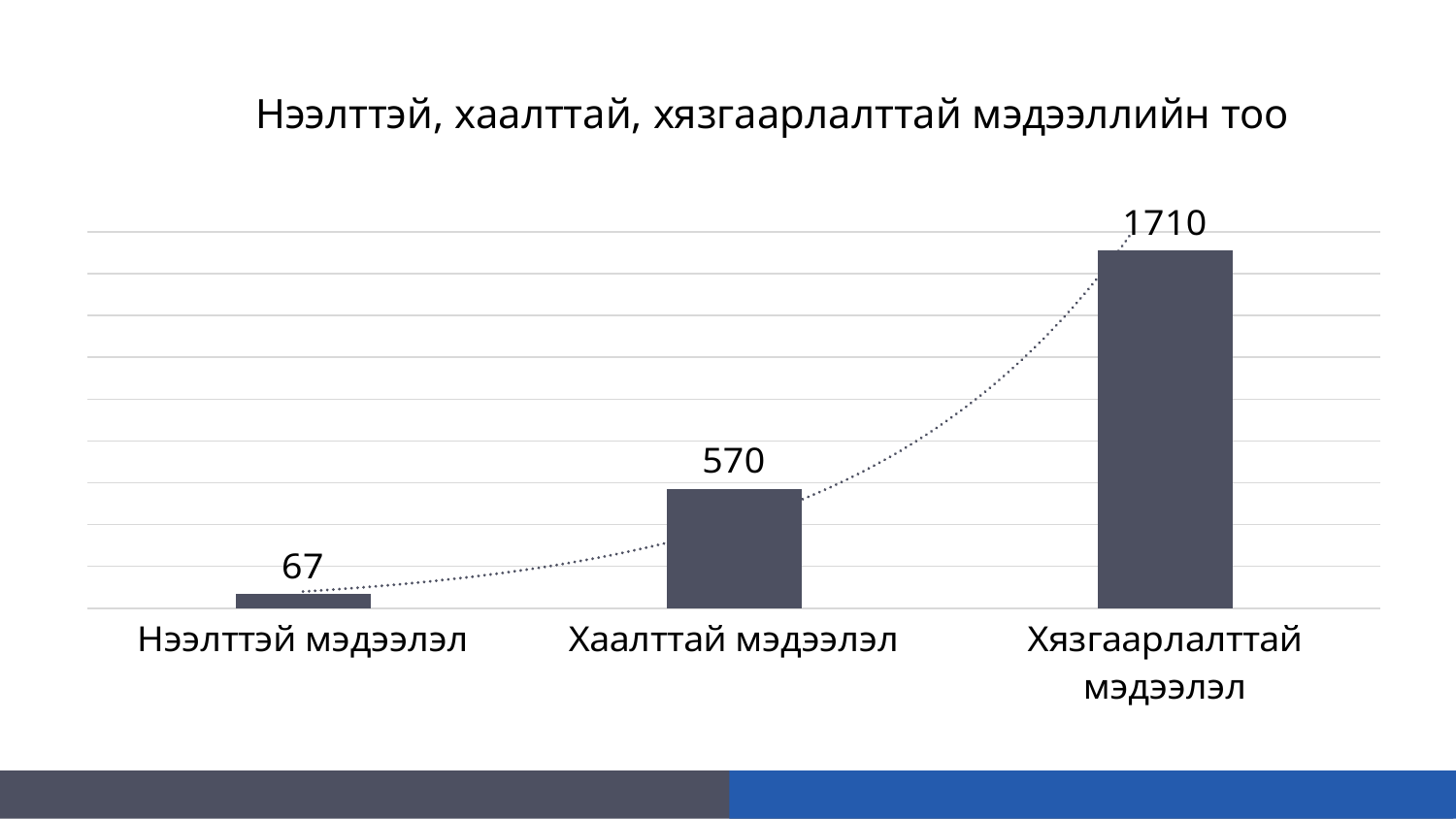
How many categories are shown in the chart? 3 Which is larger, the value for Хаалттай мэдээлэл or the value for Нээлттэй мэдээлэл? Хаалттай мэдээлэл What is the value for Нээлттэй мэдээлэл? 67 What is the difference between the values for Хаалттай мэдээлэл and Нээлттэй мэдээлэл? 503 Which category has the lowest value? Нээлттэй мэдээлэл Which category has the highest value? Хязгаарлалттай мэдээлэл What kind of chart is shown on the slide? Bar chart What is the title of the chart? Нээлттэй, хаалттай, хязгаарлалттай мэдээллийн тоо What is the value for Хязгаарлалттай мэдээлэл? 1710 Do the values rise or fall from left to right along the x axis? Rise What is the value for Хаалттай мэдээлэл? 570 What is the difference between the values for Хязгаарлалттай мэдээлэл and Хаалттай мэдээлэл? 1140